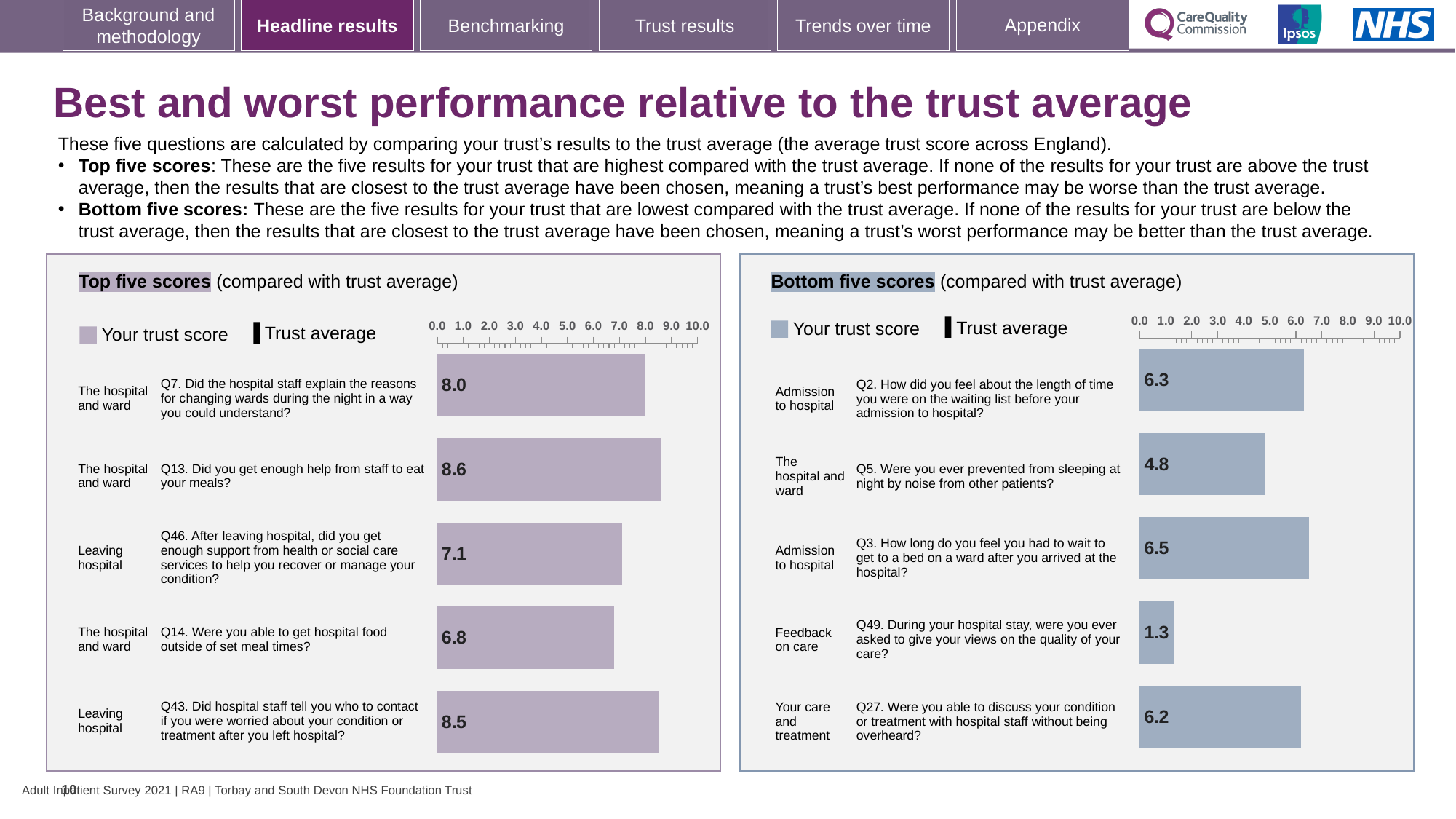
In the Top five scores chart, what is the trust score for Q46 (After leaving hospital, did you get enough support from health or social care services)? 7.1 In the Top five scores chart, what is the trust score for Q13 (Did you get enough help from staff to eat your meals?)? 8.6 In the Bottom five scores chart, what is the trust score for Q5 (Were you ever prevented from sleeping at night by noise from other patients?)? 4.8 In the Top five scores chart, which question has the lowest trust score? Q14 In the Bottom five scores chart, what is the difference between the scores for Q3 and Q49? 5.2 In the Bottom five scores chart, which question has the lowest trust score? Q49 In the Top five scores chart, which has the larger score: Q7 or Q43? Q43 How many questions are shown in the Bottom five scores chart? 5 In the Bottom five scores chart, what is the trust score for Q49 (During your hospital stay, were you ever asked to give your views on the quality of your care?)? 1.3 What type of chart is the Top five scores chart? Bar chart In the Top five scores chart, which question has the highest trust score? Q13 In the Top five scores chart, what is the difference between the scores for Q13 and Q14? 1.8